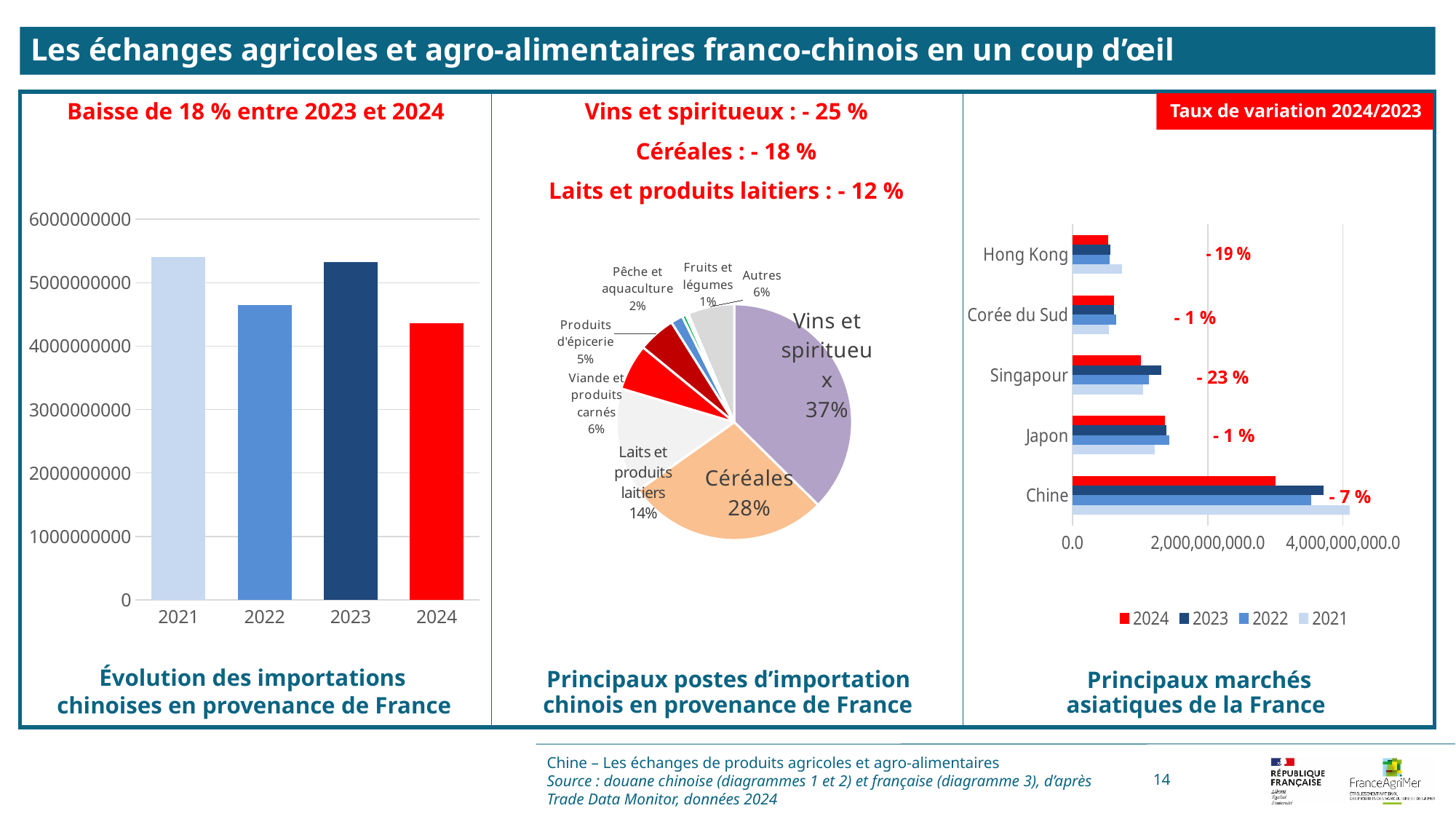
In the right chart 'Principaux marchés asiatiques de la France', what is the taux de variation 2024/2023 shown for Singapour? - 23 % In the left chart 'Évolution des importations chinoises en provenance de France', how many years are shown on the x axis? 4 In the middle pie chart 'Principaux postes d'importation chinois en provenance de France', what share does Céréales have? 28% In the left chart 'Évolution des importations chinoises en provenance de France', which year has the lowest value? 2024 In the left chart 'Évolution des importations chinoises en provenance de France', is the value for 2024 greater or less than 5000000000? less In the middle pie chart 'Principaux postes d'importation chinois en provenance de France', which category has the largest share? Vins et spiritueux In the left chart 'Évolution des importations chinoises en provenance de France', is the value for 2021 greater or less than 5000000000? greater In the middle pie chart 'Principaux postes d'importation chinois en provenance de France', how many slices are there? 8 What kind of chart is the left chart, 'Évolution des importations chinoises en provenance de France'? bar chart In the right chart 'Principaux marchés asiatiques de la France', how many series does the legend list? 4 In the right chart 'Principaux marchés asiatiques de la France', is the 2024 value for Chine greater or less than 2,000,000,000.0? greater In the middle pie chart 'Principaux postes d'importation chinois en provenance de France', what is the difference in percentage points between Vins et spiritueux and Laits et produits laitiers? 23